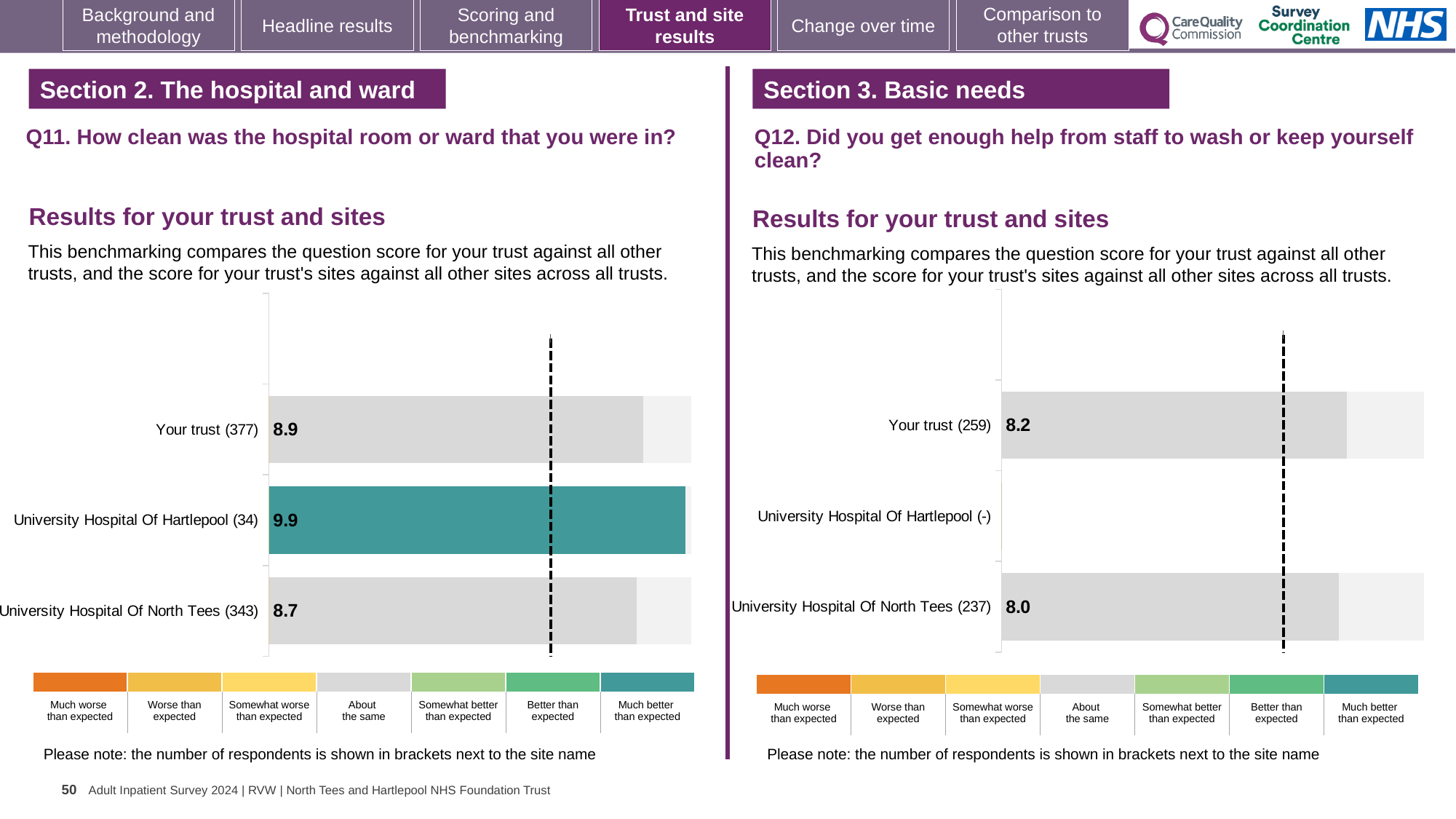
In the Q11 chart on the left, which site or trust has the lowest score? University Hospital Of North Tees What kind of chart is used for the Q11 results on the left? Bar chart In the Q12 chart on the right, what is the score for Your trust? 8.2 In the Q11 chart on the left, how many respondents are shown in brackets for University Hospital Of Hartlepool? 34 In the Q12 chart on the right, which is larger, the score for Your trust or for University Hospital Of North Tees? Your trust In the Q12 chart on the right, what is the score for University Hospital Of North Tees? 8.0 In the Q11 chart on the left, what is the score for Your trust? 8.9 In the Q11 chart on the left, which site or trust has the highest score? University Hospital Of Hartlepool In the Q12 chart on the right, what is the difference between the scores for Your trust and University Hospital Of North Tees? 0.2 In the Q11 chart on the left, what is the difference between the scores for University Hospital Of Hartlepool and University Hospital Of North Tees? 1.2 In the Q11 chart on the left, what is the score for University Hospital Of Hartlepool? 9.9 In the Q11 chart on the left, what is the score for University Hospital Of North Tees? 8.7